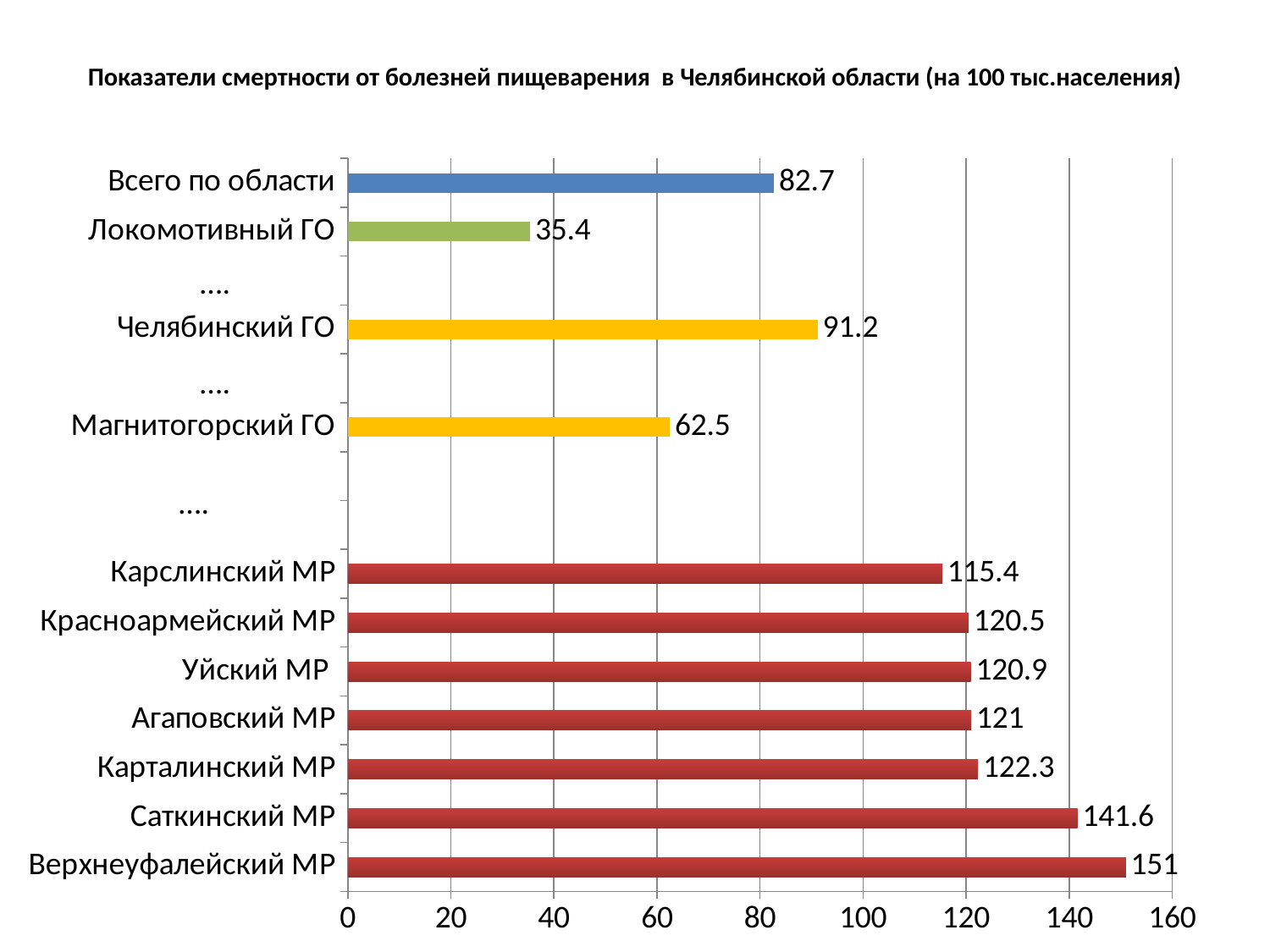
What is the difference between the values for Всего по области and Локомотивный ГО? 47.3 Is the value for Карталинский МР greater or less than 120? greater How many bars are plotted on the chart? 11 What is the value for Всего по области? 82.7 Which is larger, the value for Челябинский ГО or the value for Магнитогорский ГО? Челябинский ГО Which category has the lowest value? Локомотивный ГО What kind of chart is shown on the slide? bar chart Which category has the highest value? Верхнеуфалейский МР What is the difference between the values for Верхнеуфалейский МР and Саткинский МР? 9.4 What is the value for Саткинский МР? 141.6 What is the value for Челябинский ГО? 91.2 What is the value for Локомотивный ГО? 35.4